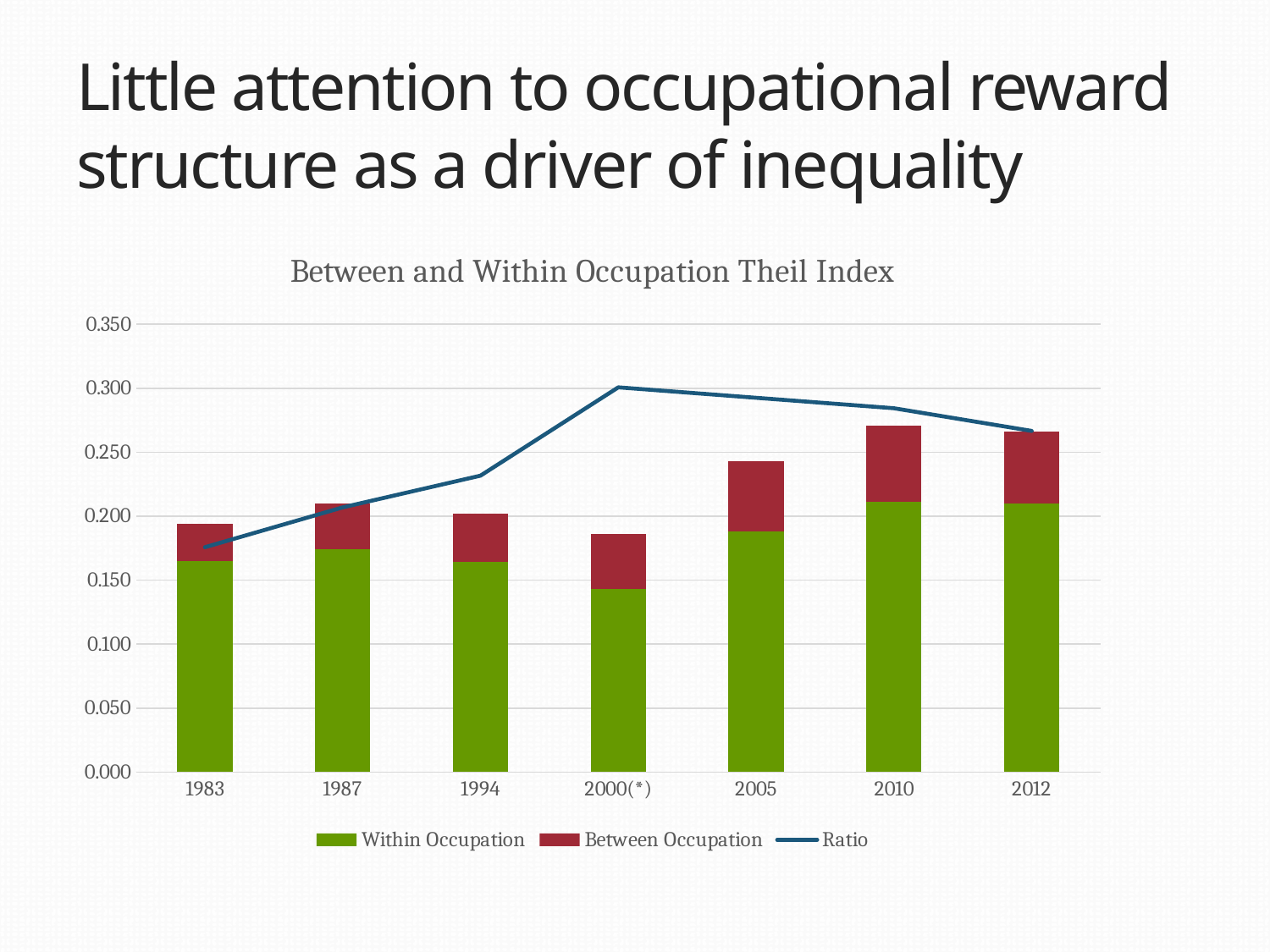
Is the Ratio value for 1983 greater or less than 0.200? less Is the Within Occupation value for 1983 greater or less than 0.200? less Which is larger, the Within Occupation value for 2005 or for 1983? 2005 How many series does the legend list? 3 Is the total stacked bar for 2010 greater or less than 0.250? greater What is the title of the chart? Between and Within Occupation Theil Index Does the Ratio line rise or fall from 1983 to 2000(*)? rise How many years are shown on the x axis? 7 In which year is the Within Occupation value lowest? 2000(*) Which series is drawn as a line rather than bars? Ratio In which year does the Ratio line reach its highest point? 2000(*) What kind of chart is this? Stacked bar chart with a line